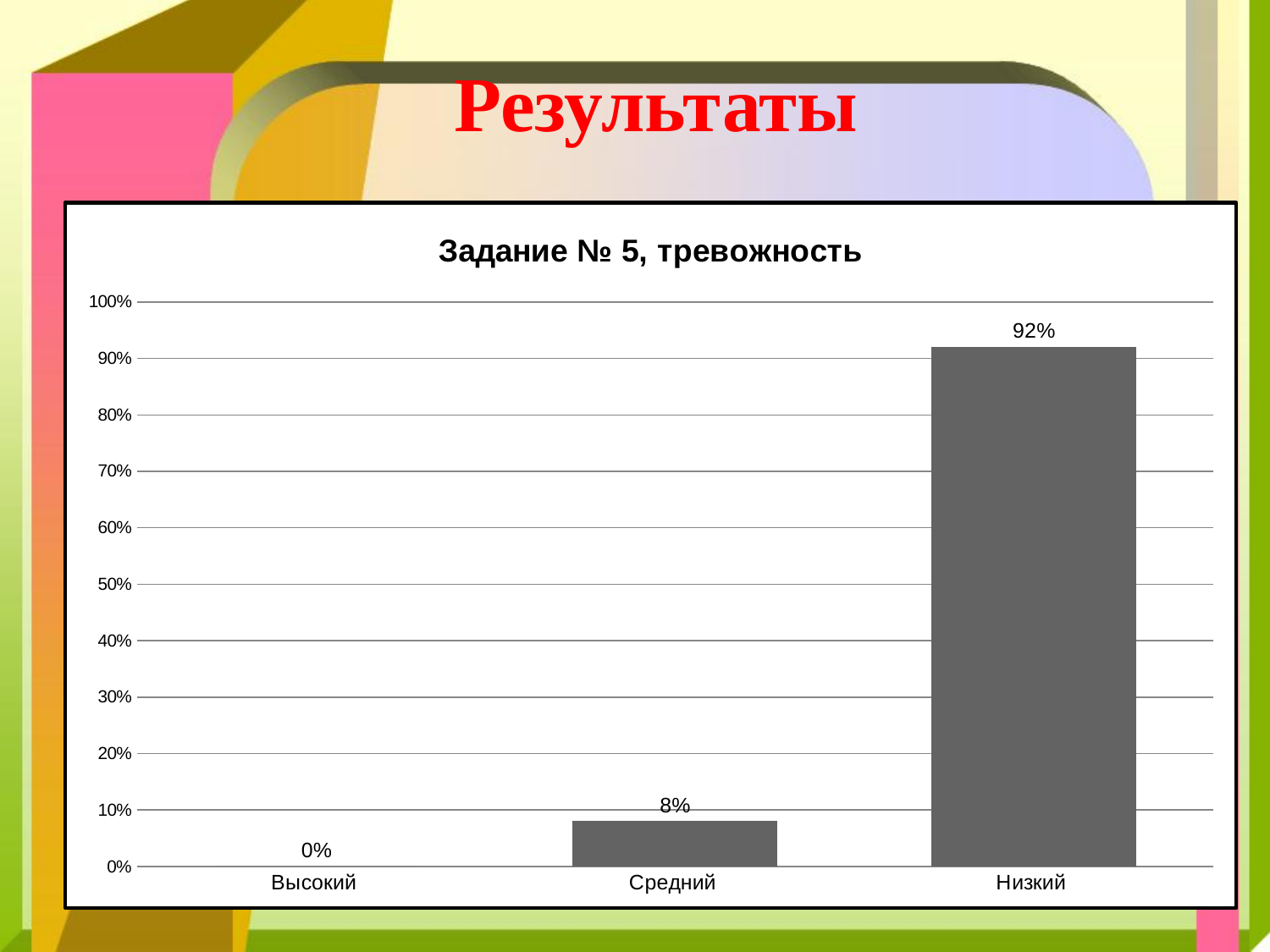
Which category has the highest value? Низкий What is the value for Средний? 8% What is the difference between the values for Низкий and Средний? 84% What is the value for Низкий? 92% Is the value for Низкий greater or less than 90%? greater Which category has the lowest value? Высокий What is the value for Высокий? 0% How many categories are shown on the x axis? 3 What is the title of the chart? Задание № 5, тревожность Which is larger, the value for Средний or the value for Высокий? Средний What kind of chart is shown? bar chart Do the values rise or fall from left to right along the x axis? rise